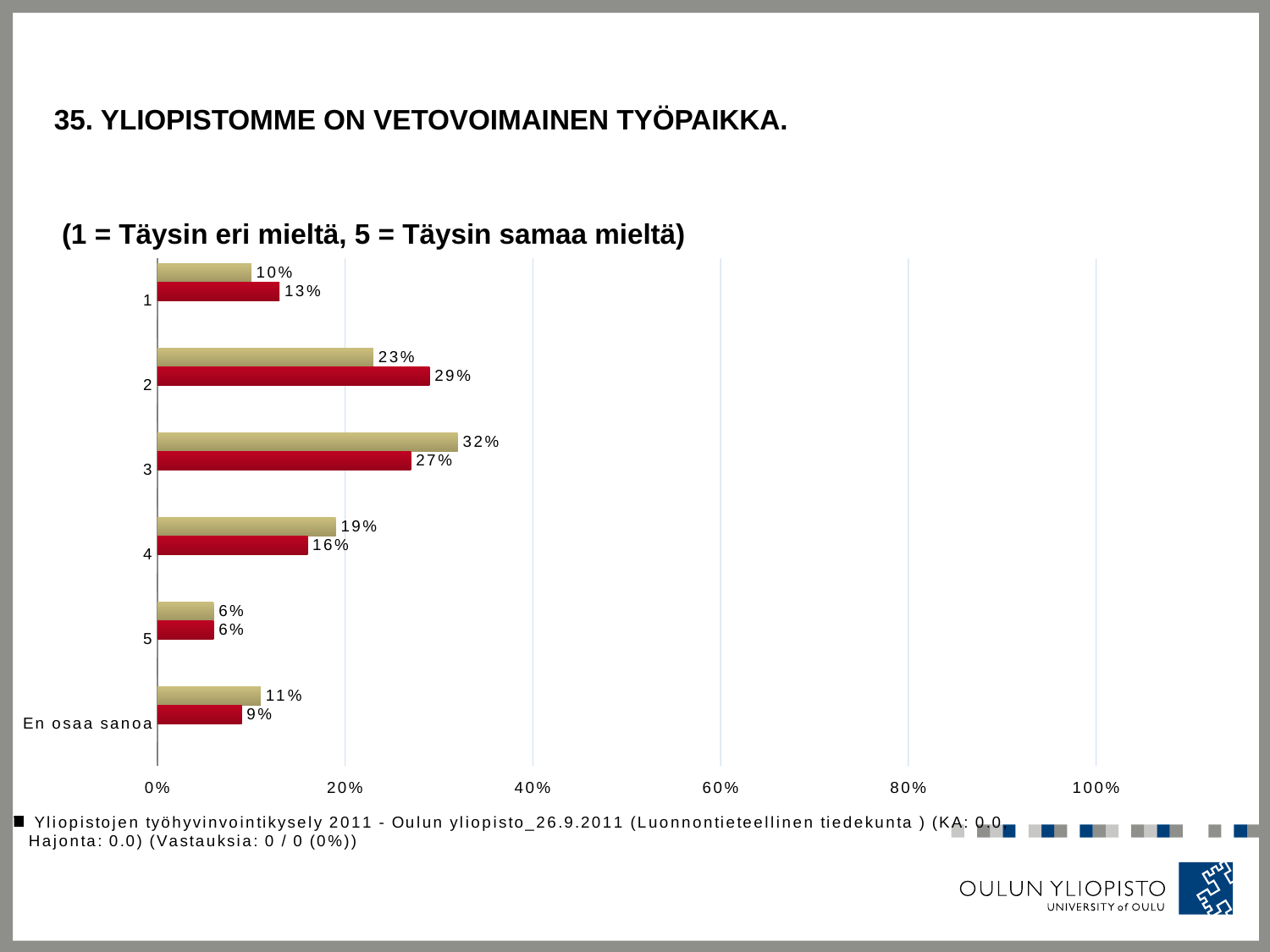
Which category has the highest value among the red bars? 2 Which category has the highest value among the tan bars? 3 What is the value of the red bar for 'En osaa sanoa'? 9% What is the difference between the tan bar and the red bar for category 3? 5% How many categories are shown on the vertical axis? 6 Is the value of the tan bar for category 3 greater or less than 20%? greater What is the value of the red bar for category 3? 27% What is the value of the tan bar for category 2? 23% What kind of chart is shown on the slide? bar chart Which category has the lowest value among the tan bars? 5 What is the difference between the red bar and the tan bar for category 2? 6% Which is larger for category 1, the tan bar or the red bar? the red bar